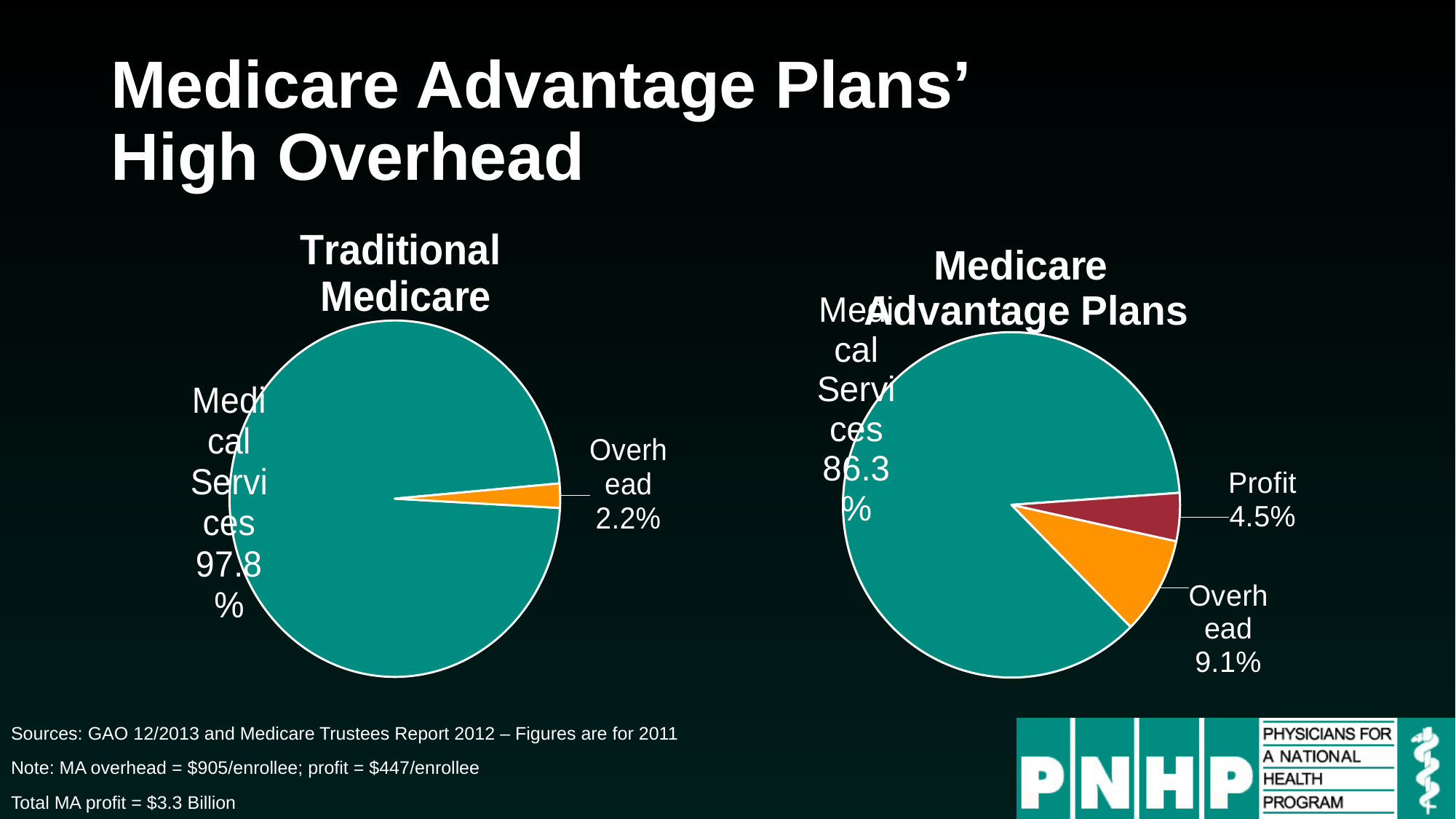
In the Medicare Advantage Plans chart, what share of the pie is Profit? 4.5% How many slices does the Medicare Advantage Plans chart have? 3 In the Medicare Advantage Plans chart, which is larger, Overhead or Profit? Overhead What is the difference between the Overhead share in the Medicare Advantage Plans chart and the Overhead share in the Traditional Medicare chart? 6.9% In the Medicare Advantage Plans chart, what is the combined share of Overhead and Profit? 13.6% In the Medicare Advantage Plans chart, which slice is the smallest? Profit In the Medicare Advantage Plans chart, what share of the pie is Overhead? 9.1% In the Traditional Medicare chart, what share of the pie is Medical Services? 97.8% What type of chart is the Traditional Medicare chart? Pie chart In the Medicare Advantage Plans chart, what share of the pie is Medical Services? 86.3% In the Traditional Medicare chart, what share of the pie is Overhead? 2.2% In the Medicare Advantage Plans chart, which slice is the largest? Medical Services